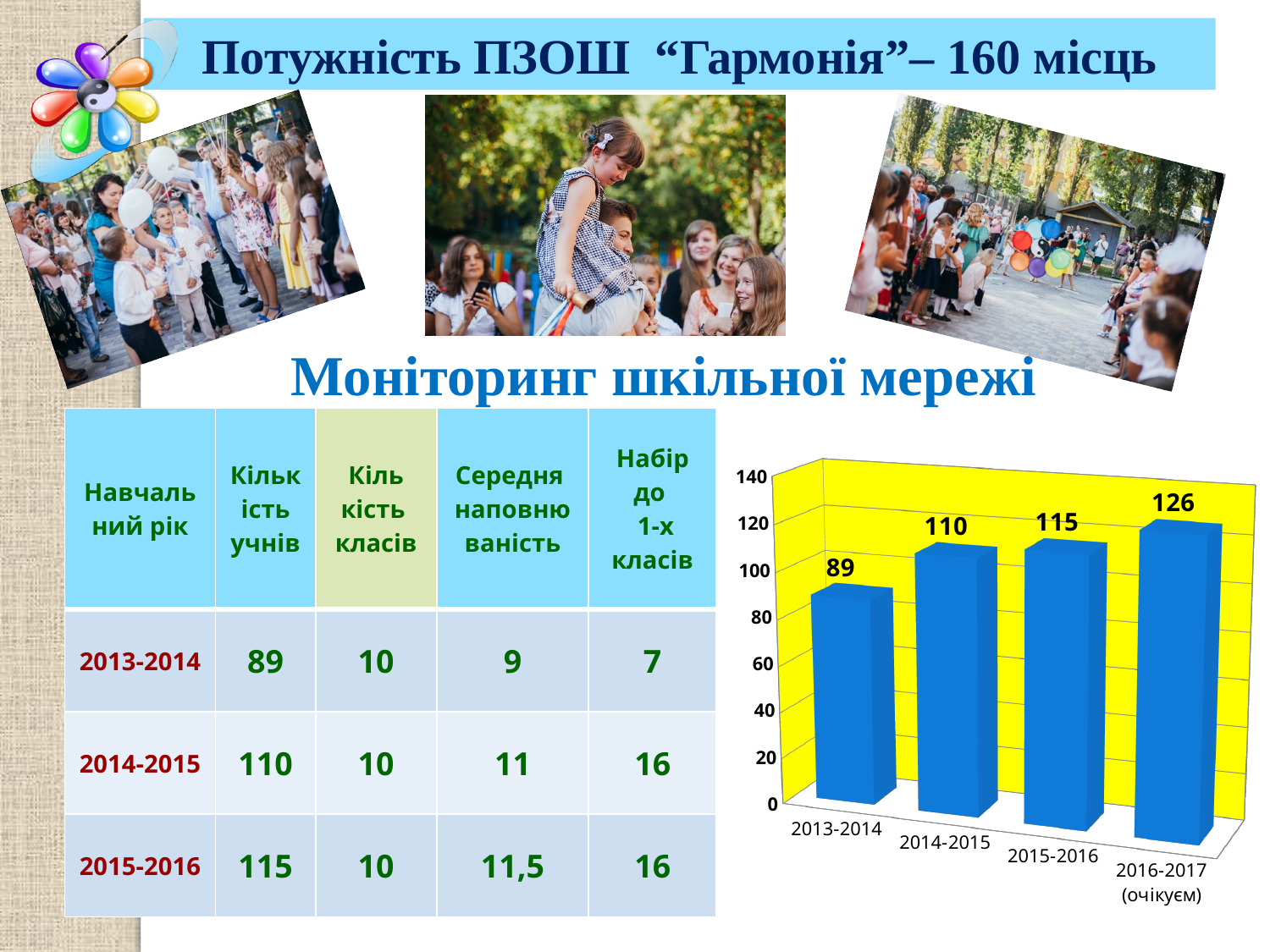
What kind of chart is shown on the slide? bar chart What is the value for 2016-2017 (очікуєм) in the bar chart? 126 Which is larger in the bar chart, the value for 2015-2016 or the value for 2014-2015? 2015-2016 How many categories are shown in the bar chart? 4 What is the difference between the values for 2016-2017 (очікуєм) and 2013-2014 in the bar chart? 37 Which category has the highest value in the bar chart? 2016-2017 (очікуєм) What is the value for 2013-2014 in the bar chart? 89 What is the difference between the values for 2014-2015 and 2013-2014 in the bar chart? 21 Do the values in the bar chart rise or fall from 2013-2014 to 2016-2017? rise Which category has the lowest value in the bar chart? 2013-2014 What is the value for 2015-2016 in the bar chart? 115 What is the value for 2014-2015 in the bar chart? 110